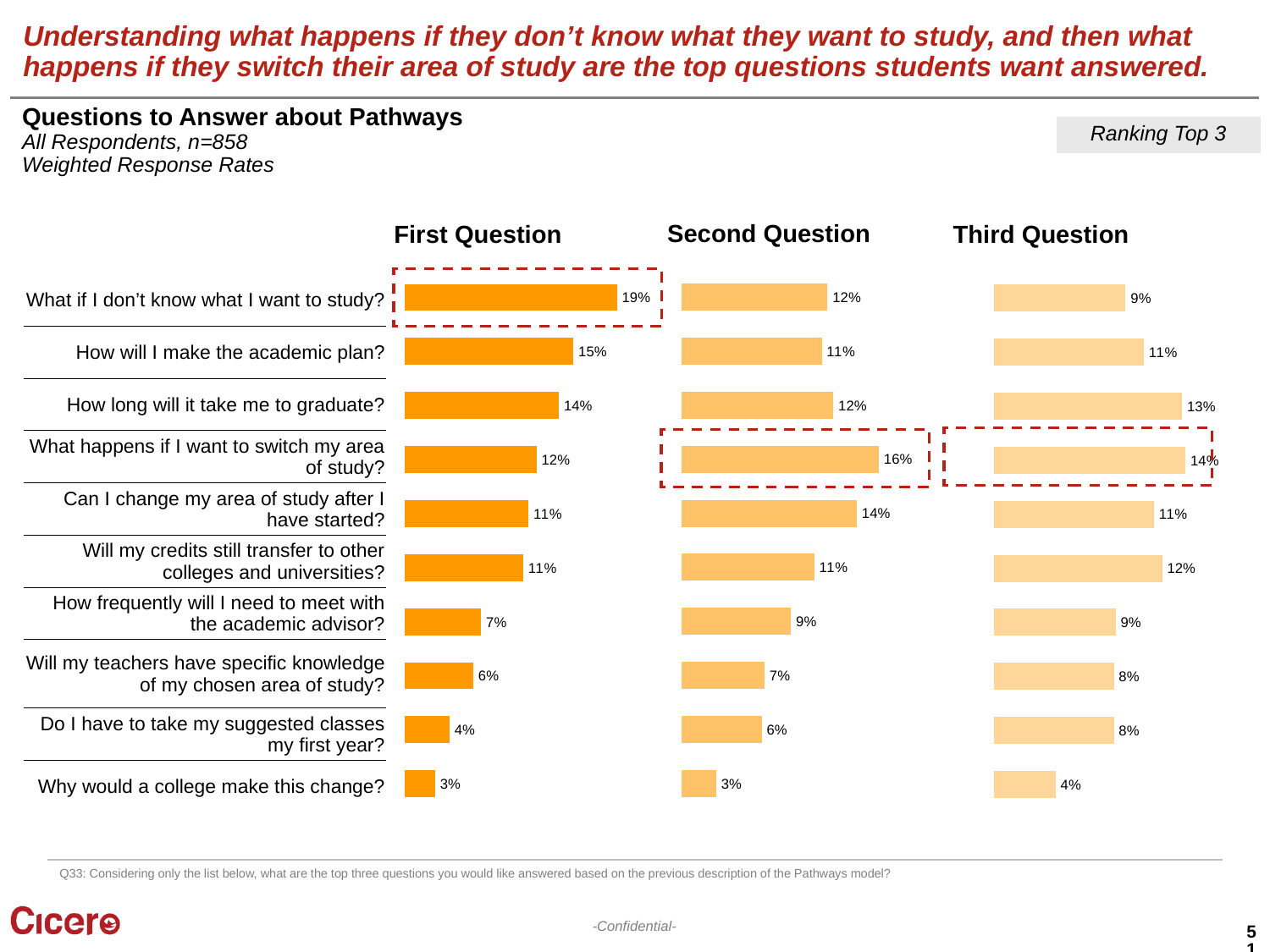
In the Second Question chart, what is the value for "What happens if I want to switch my area of study?" 16% What is the sample size (n) stated in the chart subtitle? 858 In the Second Question chart, which is larger: "Can I change my area of study after I have started?" or "How frequently will I need to meet with the academic advisor?" Can I change my area of study after I have started? How many categories are shown in the First Question chart? 10 In the First Question chart, what is the value for "What if I don't know what I want to study?" 19% In the Third Question chart, what is the value for "How long will it take me to graduate?" 13% In the First Question chart, which category has the highest value? What if I don't know what I want to study? In the Third Question chart, what is the difference between "What happens if I want to switch my area of study?" and "Why would a college make this change?" 10% In the First Question chart, what is the difference between "What if I don't know what I want to study?" and "How will I make the academic plan?" 4% What type of chart is the Third Question chart? Bar chart In the Second Question chart, which category has the lowest value? Why would a college make this change? In the Third Question chart, which category has the highest value? What happens if I want to switch my area of study?